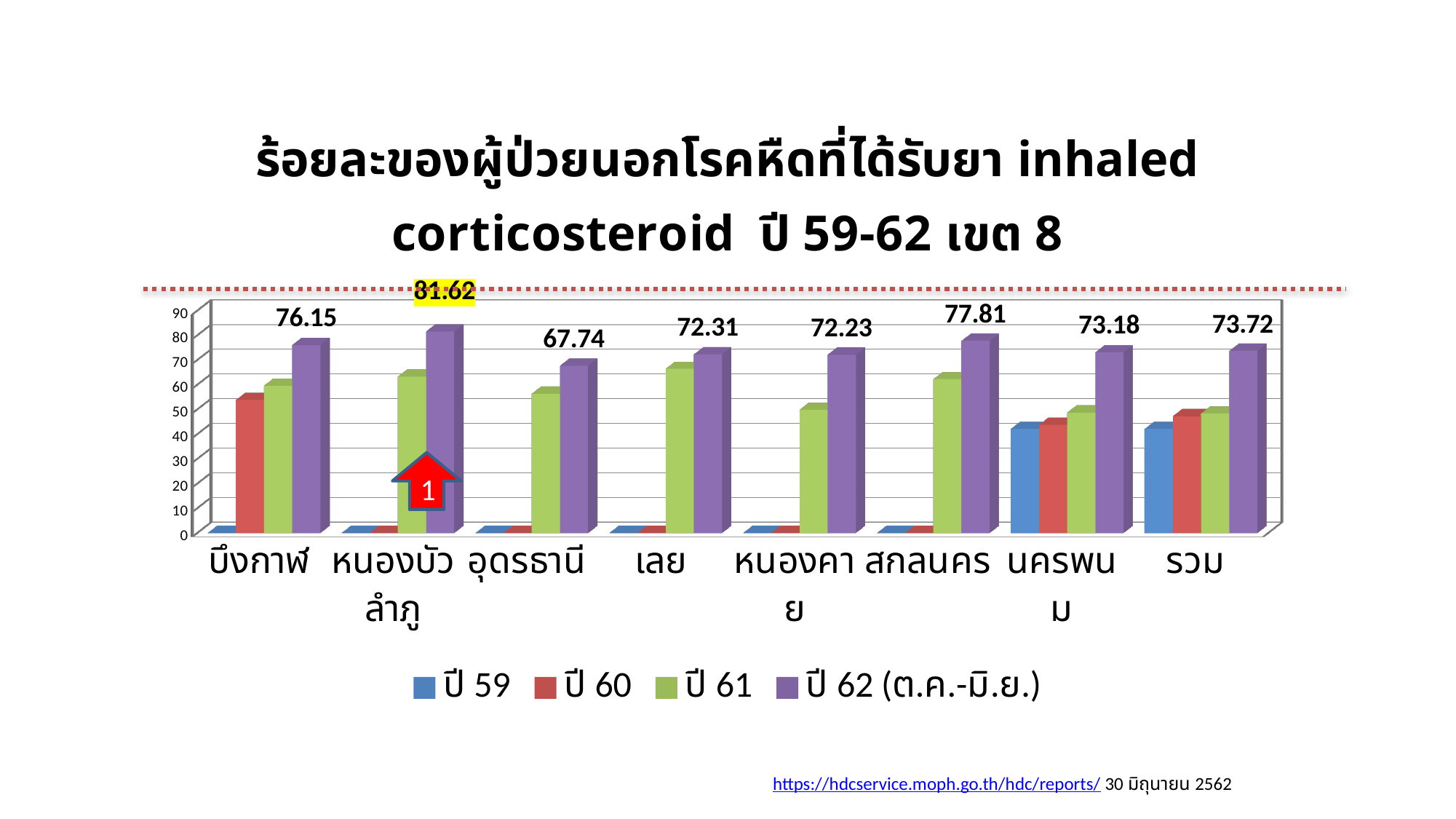
What kind of chart is shown on the slide? bar chart What is the value for ปี 62 (ต.ค.-มิ.ย.) in รวม? 73.72 How many categories are shown on the x axis? 8 Which colour represents ปี 62 (ต.ค.-มิ.ย.) in the legend? purple What is the value for ปี 62 (ต.ค.-มิ.ย.) in หนองบัวลำภู? 81.62 What is the value for ปี 62 (ต.ค.-มิ.ย.) in บึงกาฬ? 76.15 What is the difference between the ปี 62 (ต.ค.-มิ.ย.) values for หนองบัวลำภู and อุดรธานี? 13.88 Which province has the highest ปี 62 (ต.ค.-มิ.ย.) value? หนองบัวลำภู Which is larger for ปี 62 (ต.ค.-มิ.ย.): สกลนคร or นครพนม? สกลนคร How many series does the legend list? 4 Which category has the lowest ปี 62 (ต.ค.-มิ.ย.) value? อุดรธานี Is the ปี 61 value for หนองคาย greater or less than 60? less